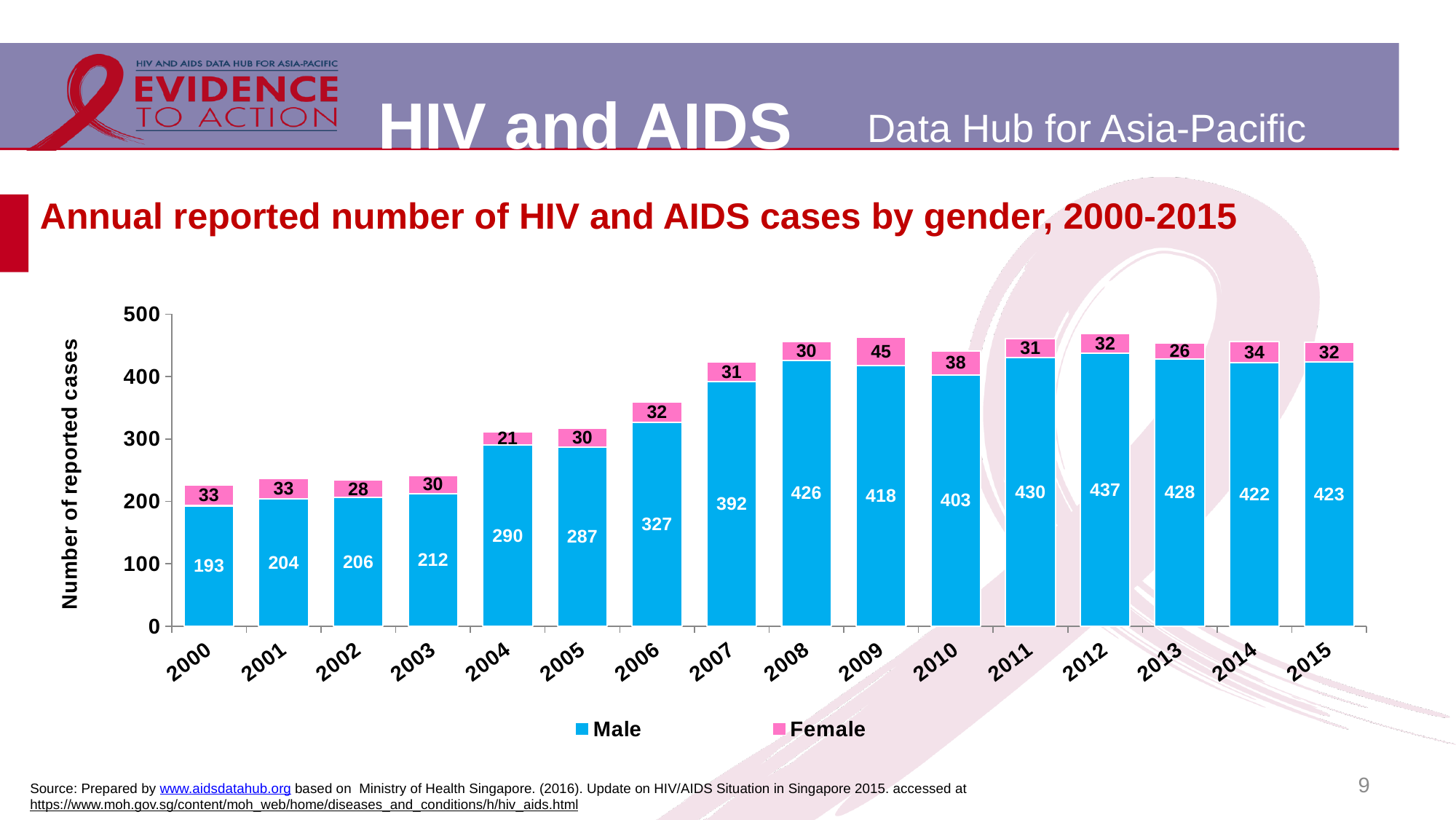
Which year has the lowest number of reported Male cases? 2000 What kind of chart is shown on the slide? Stacked bar chart How many series does the legend list? 2 Which is larger, the Male cases in 2004 or in 2005? 2004 How many years are shown on the x axis? 16 What is the label of the y axis? Number of reported cases What is the number of reported Female cases in 2009? 45 Which year has the highest number of reported Female cases? 2009 What is the difference between the Male cases in 2012 and in 2000? 244 What is the number of reported Male cases in 2008? 426 What is the total number of reported cases (Male plus Female) in 2015? 455 Which year has the highest number of reported Male cases? 2012